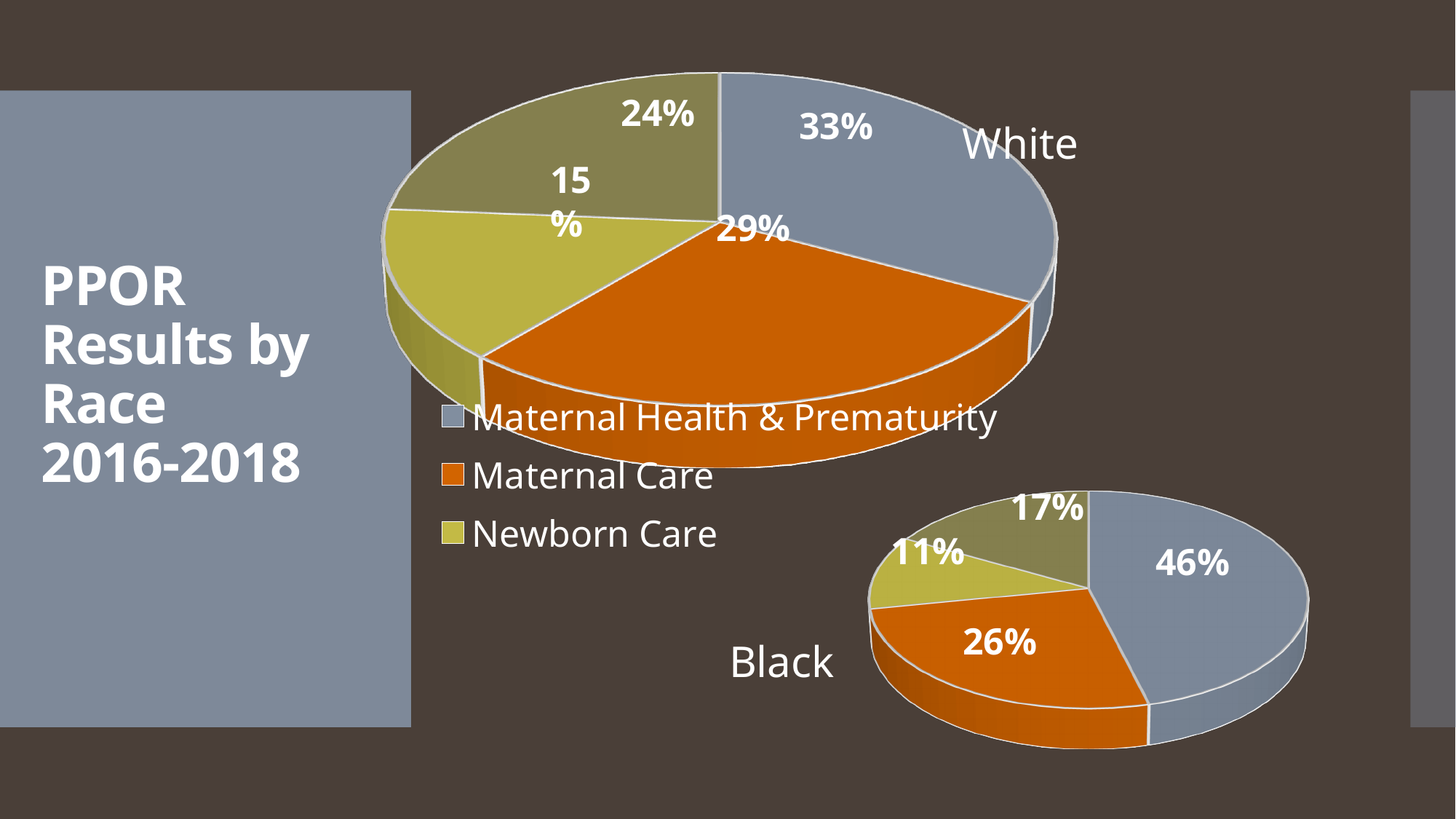
In the White pie chart, what share is Maternal Care? 29% In the White pie chart, what share is Newborn Care? 15% In the Black pie chart, what share is Maternal Care? 26% In the Black pie chart, what share is Maternal Health & Prematurity? 46% Is the Maternal Care share larger in the White pie chart or the Black pie chart? White In the Black pie chart, which category has the largest slice? Maternal Health & Prematurity In the White pie chart, what share is Maternal Health & Prematurity? 33% In the Black pie chart, what share is Newborn Care? 11% How many percentage points higher is Maternal Health & Prematurity in the Black pie chart than in the White pie chart? 13 In the Black pie chart, which category has the smallest slice? Newborn Care What type of chart is used to show the PPOR results for each race? Pie chart How many slices does the White pie chart have? 4